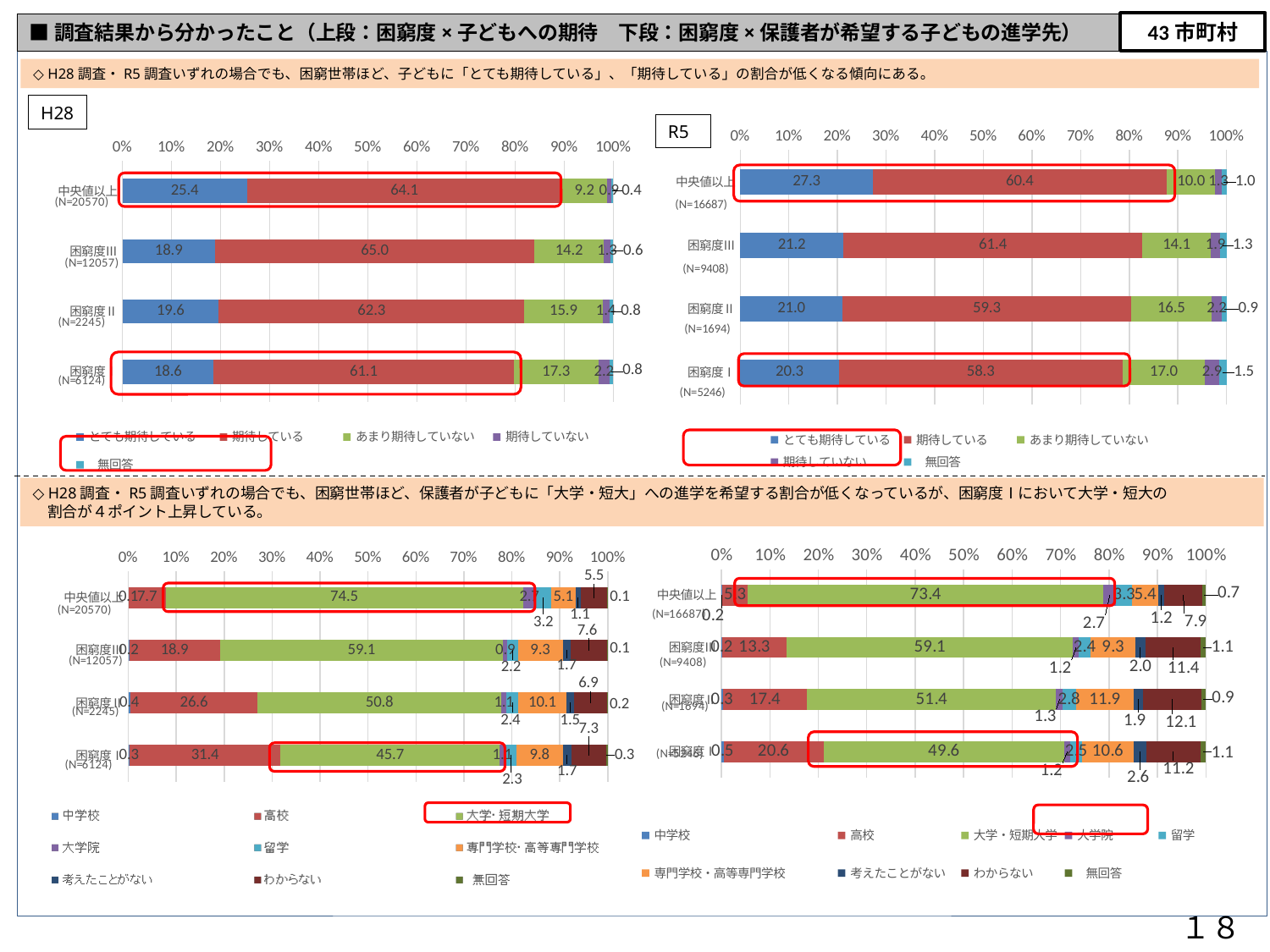
In the bottom-left H28 chart, what is the value of 大学・短期大学 for 困窮度Ⅰ? 45.7 In the top-right R5 chart, what is the difference between the 期待している values for 中央値以上 and 困窮度Ⅰ? 2.1 In the top-right R5 chart, which category has the lowest value for とても期待している? 困窮度Ⅰ In the top-right R5 chart, what is the value of 期待している for 困窮度Ⅰ? 58.3 What is the difference between the 大学・短期大学 value for 困窮度Ⅰ in the bottom-right R5 chart and in the bottom-left H28 chart? 3.9 In the top-left H28 chart, which category has the highest value for あまり期待していない? 困窮度Ⅰ In the top-left H28 chart, which is larger for 期待している: 困窮度Ⅲ or 中央値以上? 困窮度Ⅲ In the bottom-right R5 chart, does the 大学・短期大学 value rise or fall going from 中央値以上 down to 困窮度Ⅰ? fall In the top-left H28 chart, what is the value of とても期待している for 中央値以上? 25.4 How many series does the legend of the top-left H28 chart list? 5 In the bottom-right R5 chart, what is the value of 大学・短期大学 for 困窮度Ⅰ? 49.6 In the bottom-left H28 chart, what is the value of 高校 for 困窮度Ⅰ? 31.4